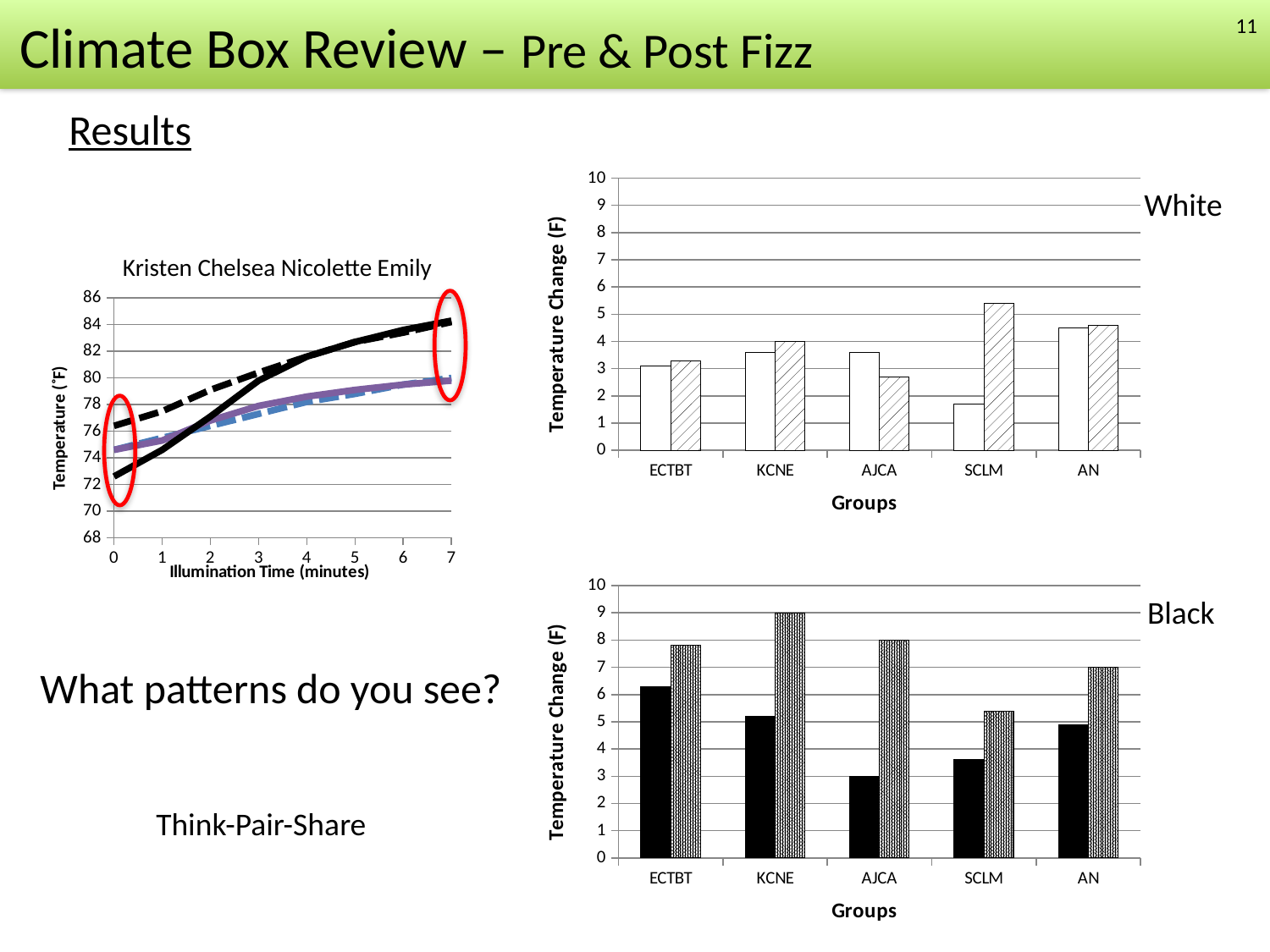
How many lines are plotted on the line chart titled "Kristen Chelsea Nicolette Emily"? 4 On the chart labeled "Black", is the solid black bar for AJCA greater or less than 4? less On the chart labeled "White", which group has the tallest bar? SCLM On the chart labeled "Black", which group has the tallest bar? KCNE On the chart labeled "White", is the hatched bar for SCLM greater or less than 5? greater On the chart labeled "Black", is the patterned bar for KCNE greater or less than 8? greater On the line chart titled "Kristen Chelsea Nicolette Emily", do the temperatures rise or fall as illumination time increases? rise What kind of chart is the chart labeled "White" on the right of the slide? bar chart On the chart labeled "Black", how many groups are shown on the x axis? 5 What is the x-axis title of the line chart titled "Kristen Chelsea Nicolette Emily"? Illumination Time (minutes) On the chart labeled "Black", which is larger: the solid black bar for ECTBT or the solid black bar for AJCA? ECTBT